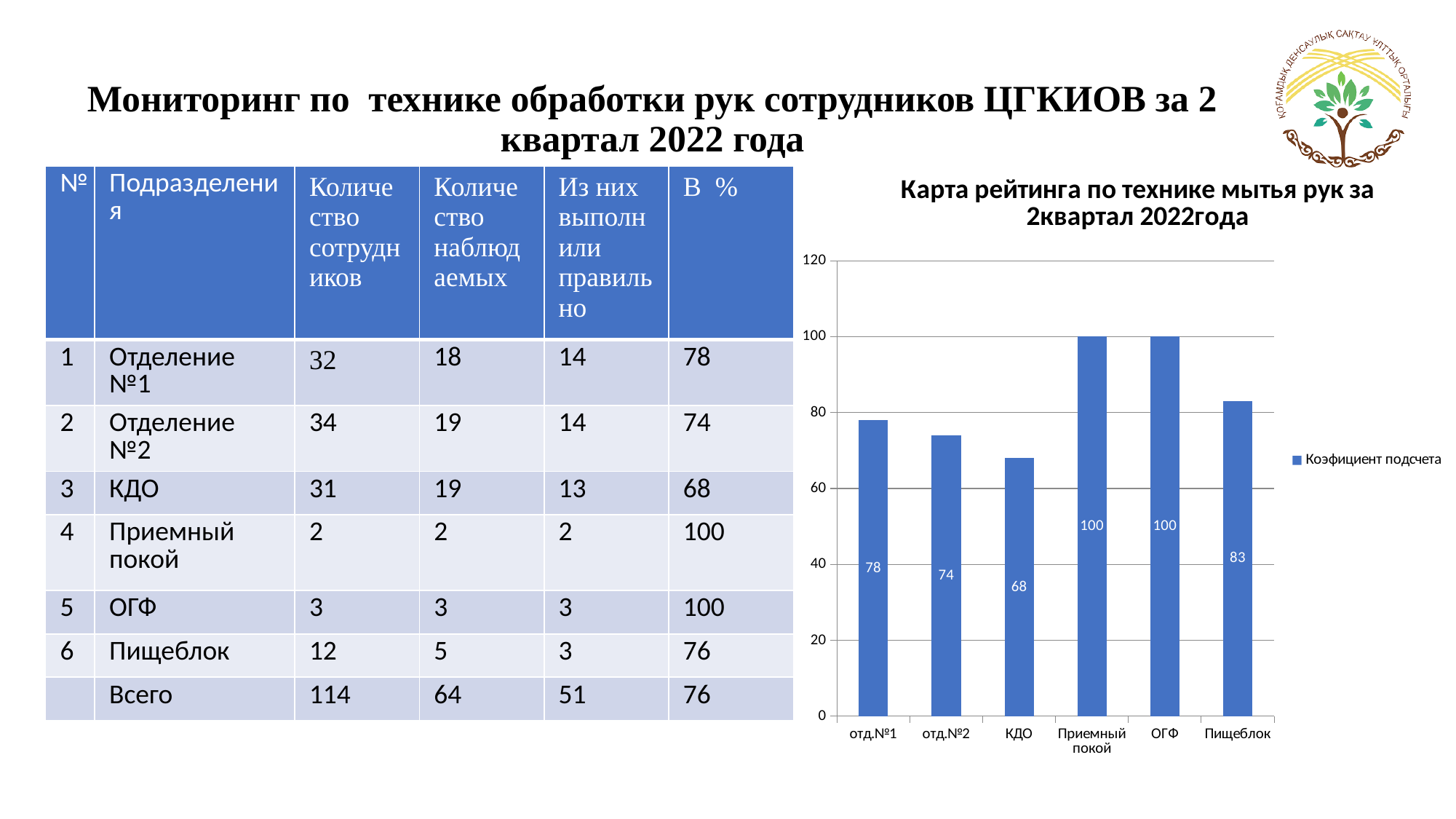
Which two categories share the highest value in the chart? Приемный покой and ОГФ How many categories are shown on the x axis of the chart? 6 What type of chart is shown on the slide? Bar chart What is the value for КДО in the chart? 68 What is the value for Пищеблок in the chart? 83 What is the title of the chart? Карта рейтинга по технике мытья рук за 2квартал 2022года What is the difference between the values for отд.№1 and КДО? 10 How many series does the chart legend list? 1 Which is larger, the value for Пищеблок or the value for отд.№2? Пищеблок What is the value for отд.№2 in the chart? 74 What is the value for ОГФ in the chart? 100 Which category has the lowest value in the chart? КДО